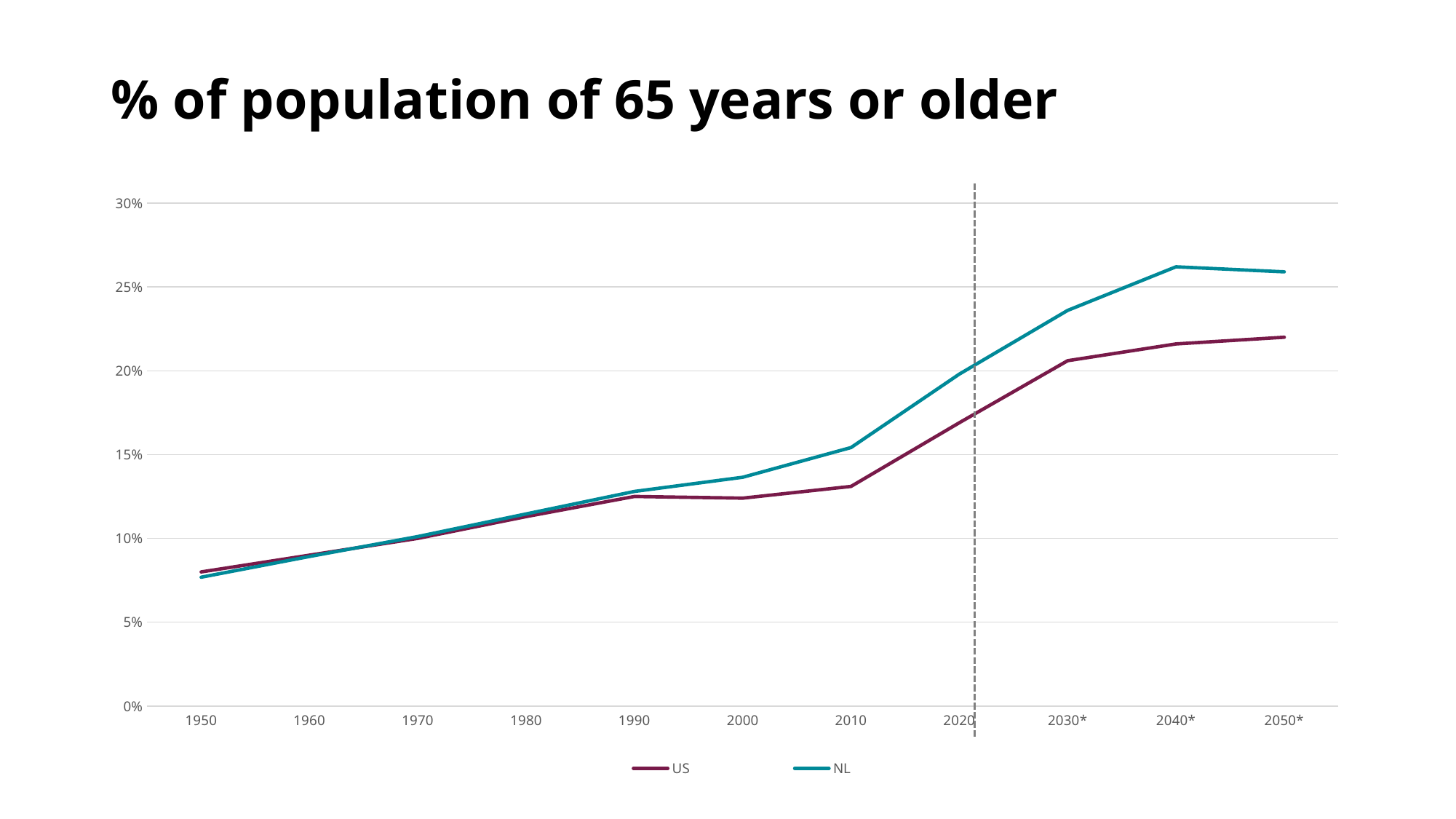
Is the value for NL in 2030* greater or less than 20%? greater Is the value for US in 2010 greater or less than 15%? less What is the title of the chart? % of population of 65 years or older What kind of chart is shown on the slide? Line chart Is the value for US in 2050* greater or less than 25%? less How many years are labelled on the x axis? 11 In which year is the NL series at its lowest value? 1950 In which year does the NL series reach its highest value? 2040* How many series does the legend list? 2 In 2050*, which series has the higher value, US or NL? NL